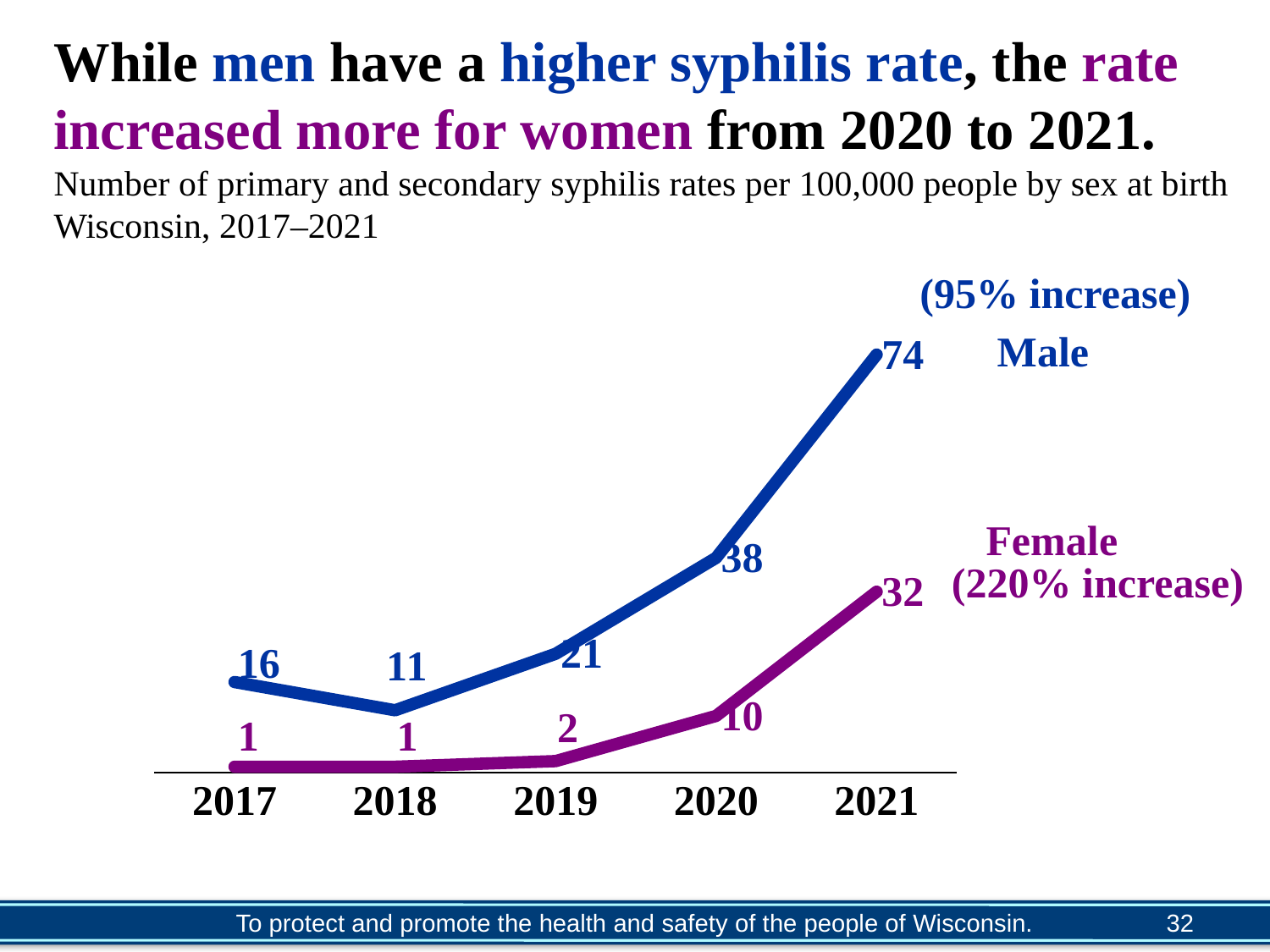
What kind of chart is shown on the slide? Line chart In which year was the male syphilis rate lowest? 2018 Which was larger in 2020, the male rate or the female rate? Male In which year was the male syphilis rate highest? 2021 By how much did the female syphilis rate increase from 2020 to 2021? 22 What is the difference between the male and female syphilis rates in 2021? 42 What was the female syphilis rate in 2019? 2 What was the male syphilis rate in 2021? 74 How many years are shown on the x axis? 5 What was the female syphilis rate in 2020? 10 What was the male syphilis rate in 2018? 11 How many series are plotted on the chart? 2